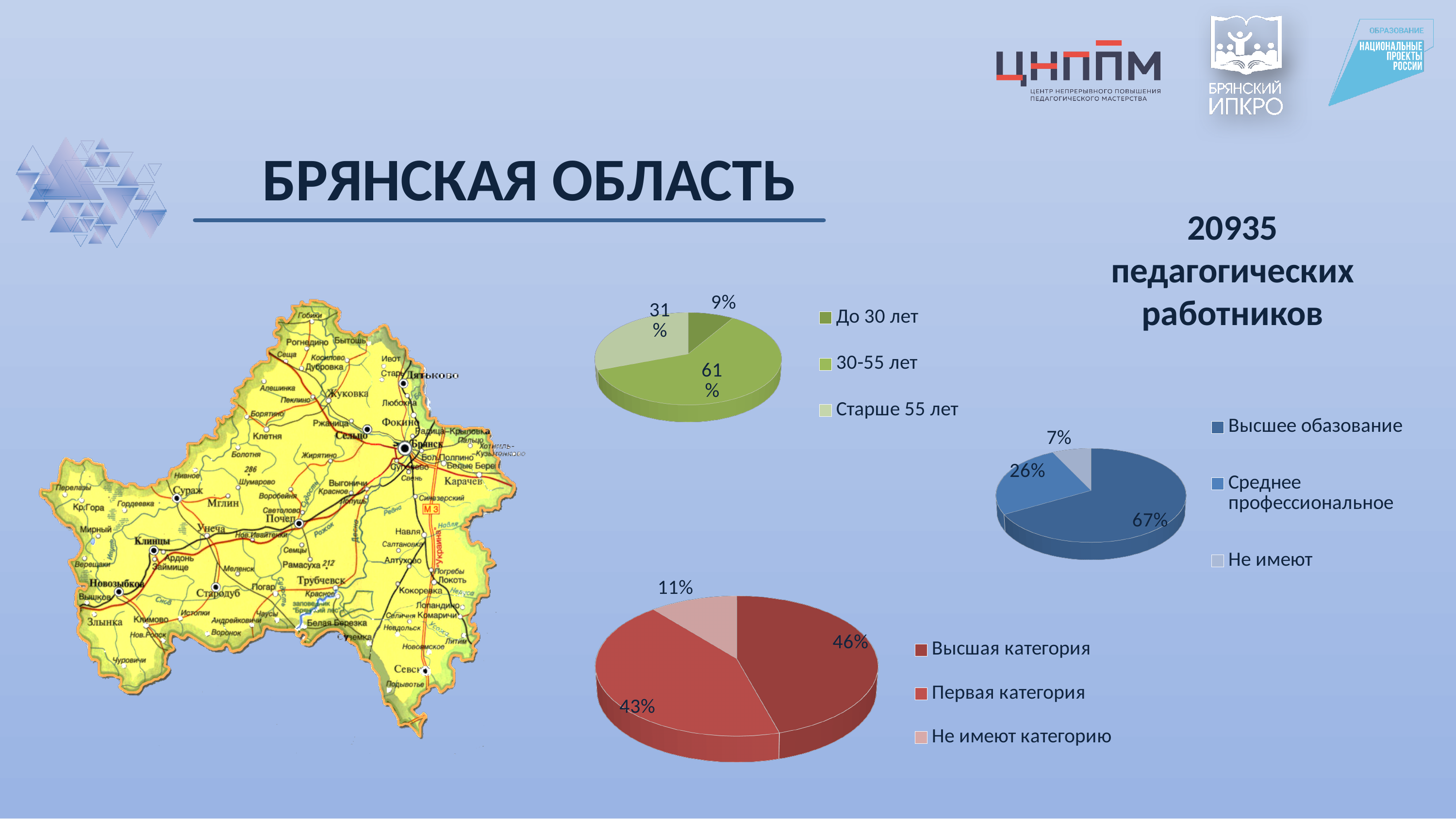
How many entries does the legend of the blue pie chart on the right of the slide list? 3 In the blue pie chart on the right of the slide, what share is labelled for 'Высшее обазование'? 67% In the green pie chart at the top middle of the slide, which category has the largest share? 30-55 лет In the green pie chart at the top middle of the slide, what share is labelled for the '30-55 лет' slice? 61% In the red pie chart at the bottom middle of the slide, how many slices does the pie have? 3 In the green pie chart at the top middle of the slide, what is the difference between the 'Старше 55 лет' share and the 'До 30 лет' share? 22% In the red pie chart at the bottom middle of the slide, which is larger: 'Высшая категория' or 'Не имеют категорию'? Высшая категория In the green pie chart at the top middle of the slide, what share is labelled for the 'До 30 лет' slice? 9% In the red pie chart at the bottom middle of the slide, what share is labelled for 'Первая категория'? 43% In the blue pie chart on the right of the slide, which category has the smallest share? Не имеют What kind of chart is the green chart at the top middle of the slide? Pie chart In the blue pie chart on the right of the slide, what is the difference between the 'Высшее обазование' share and the 'Среднее профессиональное' share? 41%